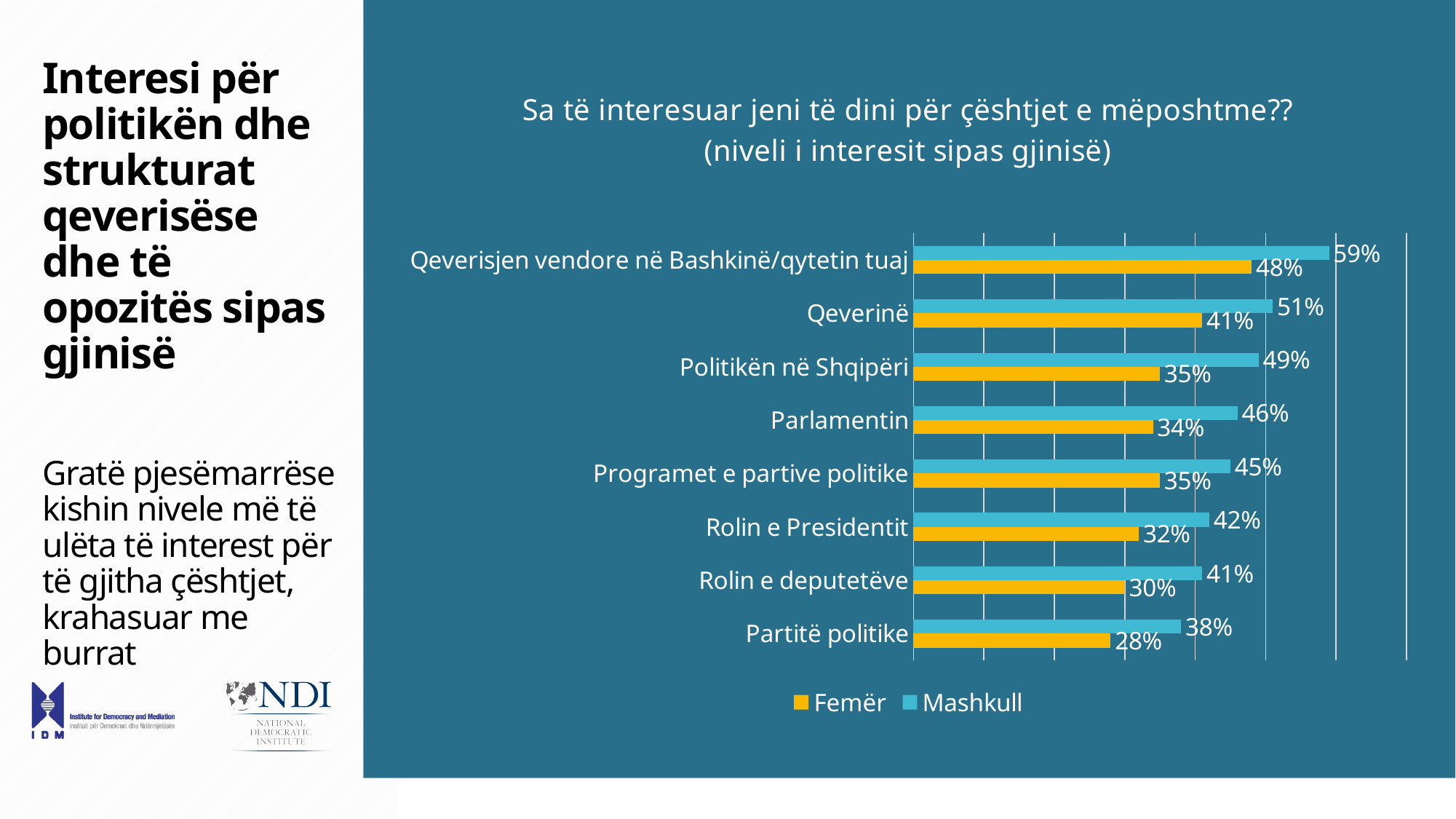
What kind of chart is shown on the slide? Bar chart What is the Femër value for Parlamentin? 34% What is the Mashkull value for Qeverisjen vendore në Bashkinë/qytetin tuaj? 59% How many categories are shown on the chart? 8 What is the Mashkull value for Rolin e deputetëve? 41% Which category has the lowest Femër value? Partitë politike How many series does the legend list? 2 Which colour represents the Femër series in the chart? Yellow What is the difference between the Mashkull and Femër values for Qeverinë? 10% Which is larger for Rolin e Presidentit, the Femër value or the Mashkull value? Mashkull Which category has the highest Mashkull value? Qeverisjen vendore në Bashkinë/qytetin tuaj What is the Femër value for Partitë politike? 28%